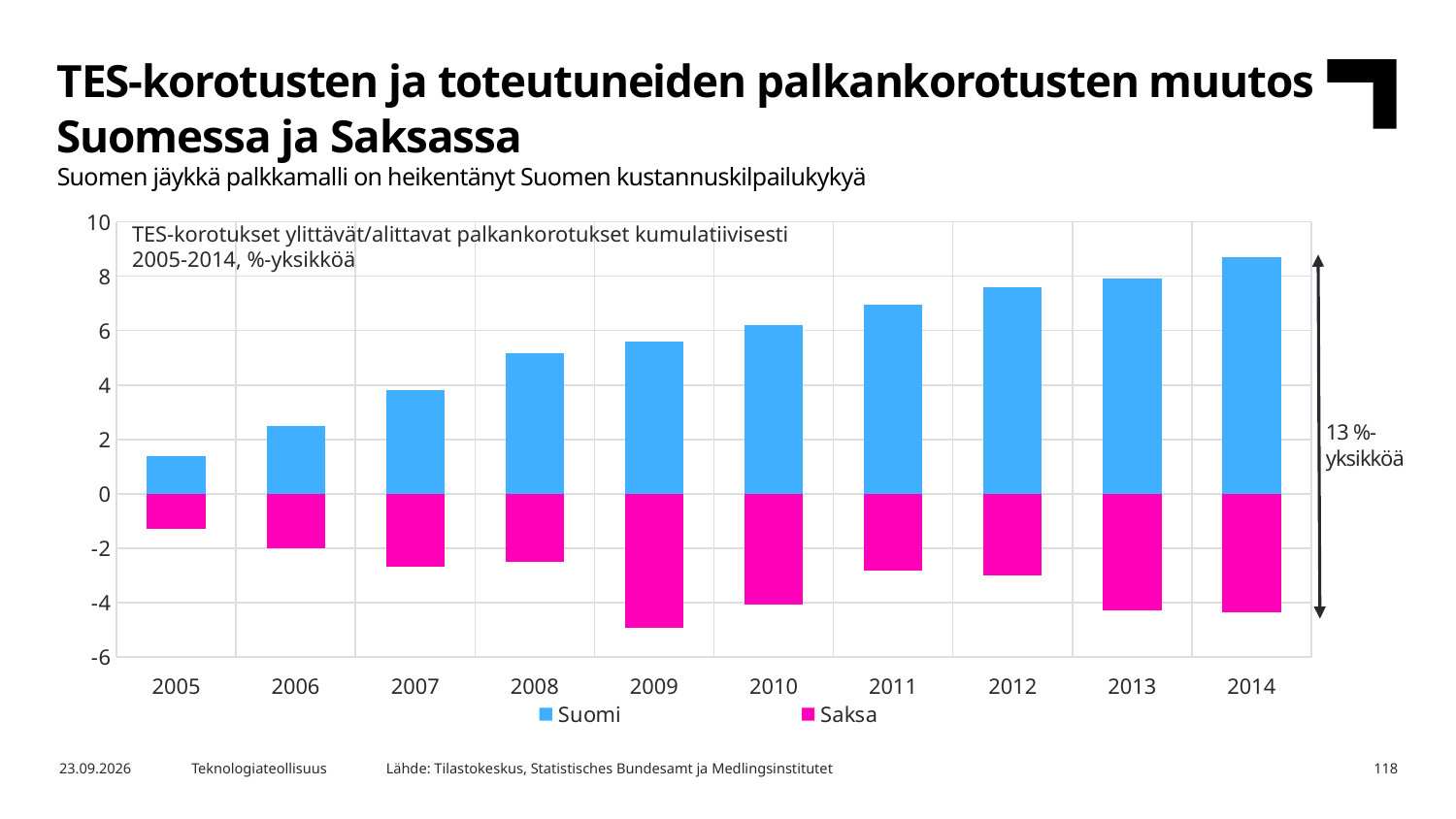
Is the Saksa value for 2009 greater or less than -4? less How many series does the chart legend list? 2 Which is larger, the Suomi value for 2010 or the Suomi value for 2008? 2010 What gap between Suomi and Saksa in 2014 does the annotation on the right of the chart state? 13 %-yksikköä In which year is the Suomi value lowest? 2005 In which year is the Suomi value highest? 2014 Is the Suomi value for 2005 greater or less than 2? less What are the two series named in the chart legend? Suomi and Saksa What kind of chart is shown on the slide? bar chart Do the Suomi values rise or fall from 2005 to 2014? rise How many years are shown on the x axis of the chart? 10 Is the Suomi value for 2014 greater or less than 8? greater